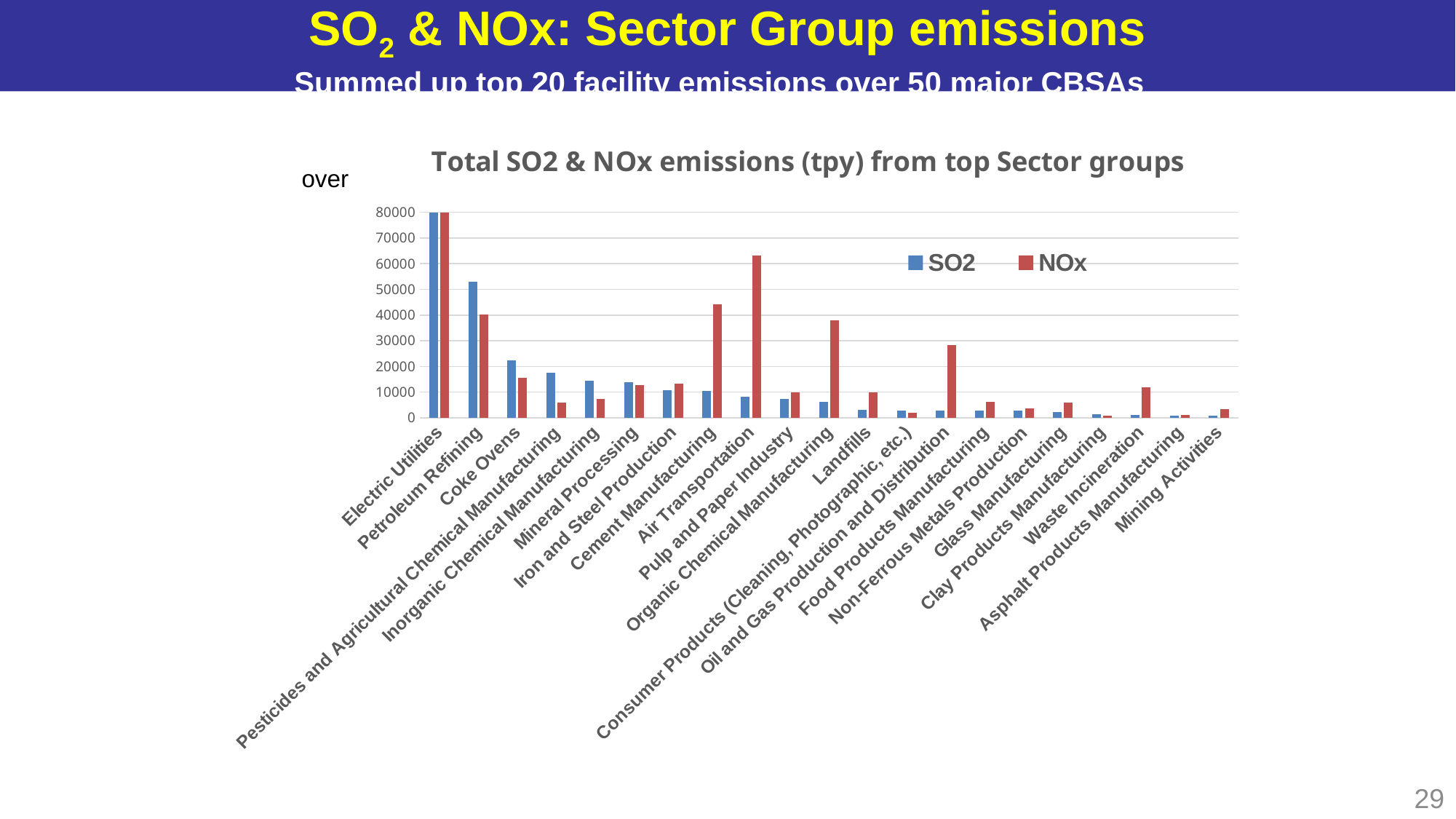
Do the SO2 values generally rise or fall moving left to right along the x axis? fall Is the SO2 value for Petroleum Refining greater or less than 40000? greater For Petroleum Refining, which is larger, SO2 or NOx emissions? SO2 Which sector group has the highest NOx emissions? Electric Utilities Which sector group has the highest SO2 emissions? Electric Utilities For Air Transportation, which is larger, SO2 or NOx emissions? NOx How many sector groups are shown on the x axis? 21 Is the NOx value for Air Transportation greater or less than 50000? greater Is the NOx value for Cement Manufacturing greater or less than 30000? greater How many series does the legend list? 2 What kind of chart is shown on the slide? bar chart